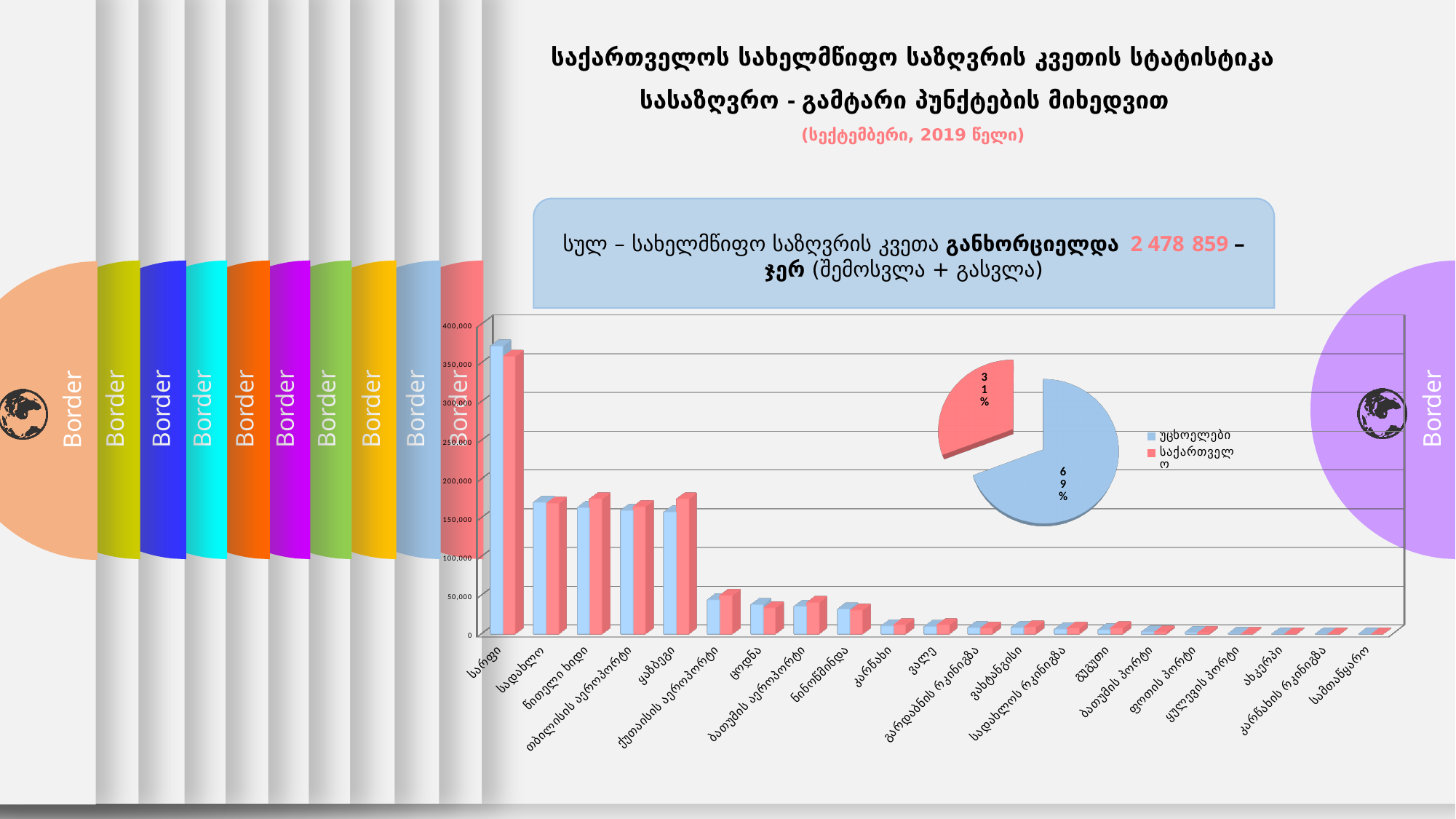
In the bar chart, is the pink bar for ცოდნა greater or less than 50,000? less In the bar chart, is the blue bar for სარფი greater or less than 300,000? greater In the pie chart, which slice is larger, უცხოელები or საქართველო? უცხოელები In the bar chart, which category has the highest bars? სარფი How many series does the legend of the pie chart list? 2 In the bar chart, which category has higher bars, სარფი or ყაზბეგი? სარფი In the bar chart, do the values generally rise or fall from left to right along the x axis? fall In the bar chart, is the blue bar for სადახლო greater or less than 200,000? less What kind of chart is the chart on the left of the slide? bar chart In the pie chart, what share does the საქართველო slice have? 31% In the pie chart, what share does the უცხოელები slice have? 69% What kind of chart is the chart on the right of the slide? pie chart